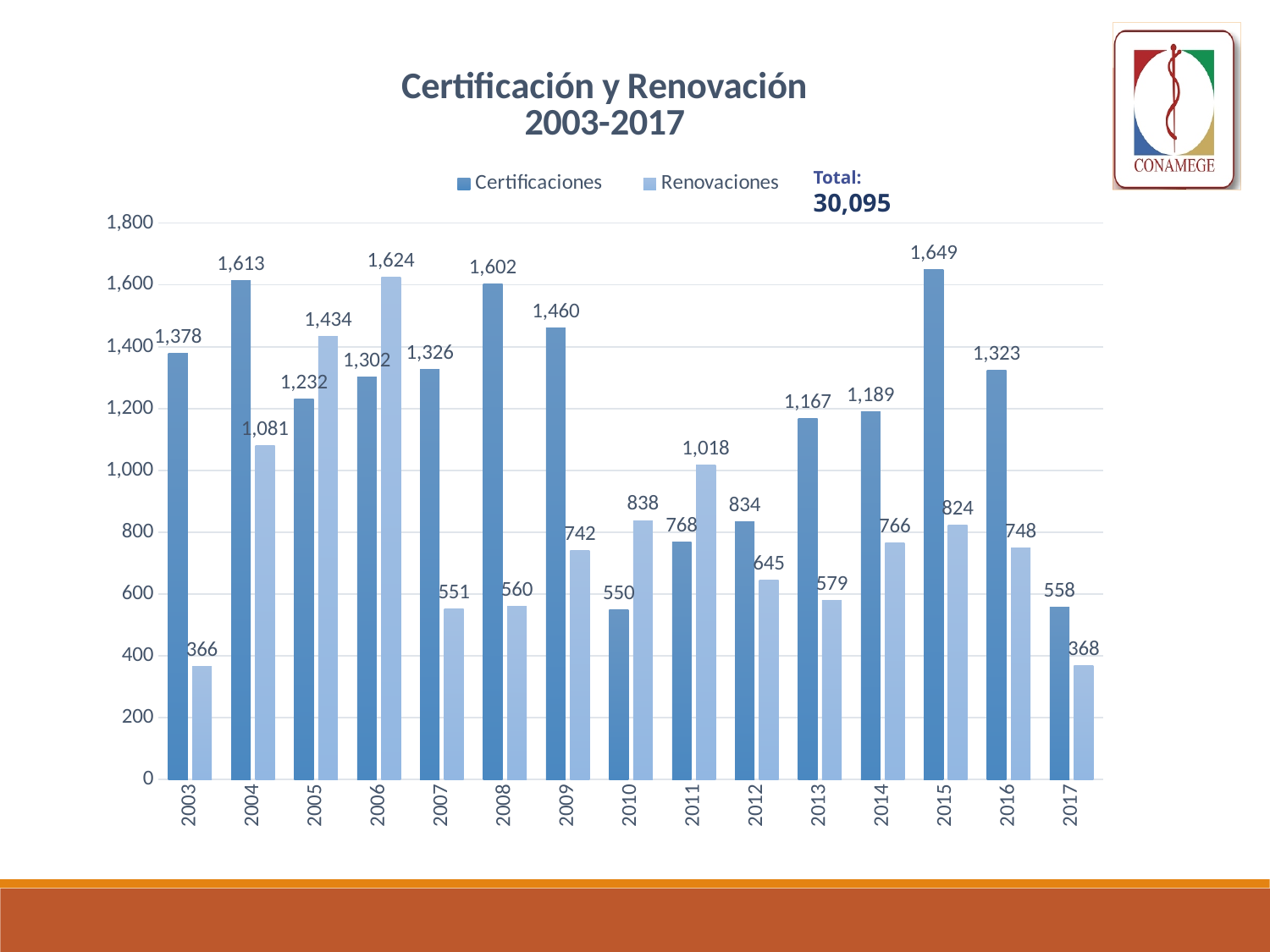
How many series does the legend list? 2 In 2011, which is larger: Certificaciones or Renovaciones? Renovaciones What kind of chart is shown on the slide? Bar chart Which year has the highest value for Certificaciones? 2015 What is the title of the chart? Certificación y Renovación 2003-2017 What total is printed next to the legend? 30,095 What is the difference between Certificaciones and Renovaciones in 2015? 825 What is the value of Certificaciones for 2010? 550 How many years are shown on the x axis? 15 What is the value of Certificaciones for 2015? 1,649 Which year has the lowest value for Renovaciones? 2003 What is the value of Renovaciones for 2006? 1,624